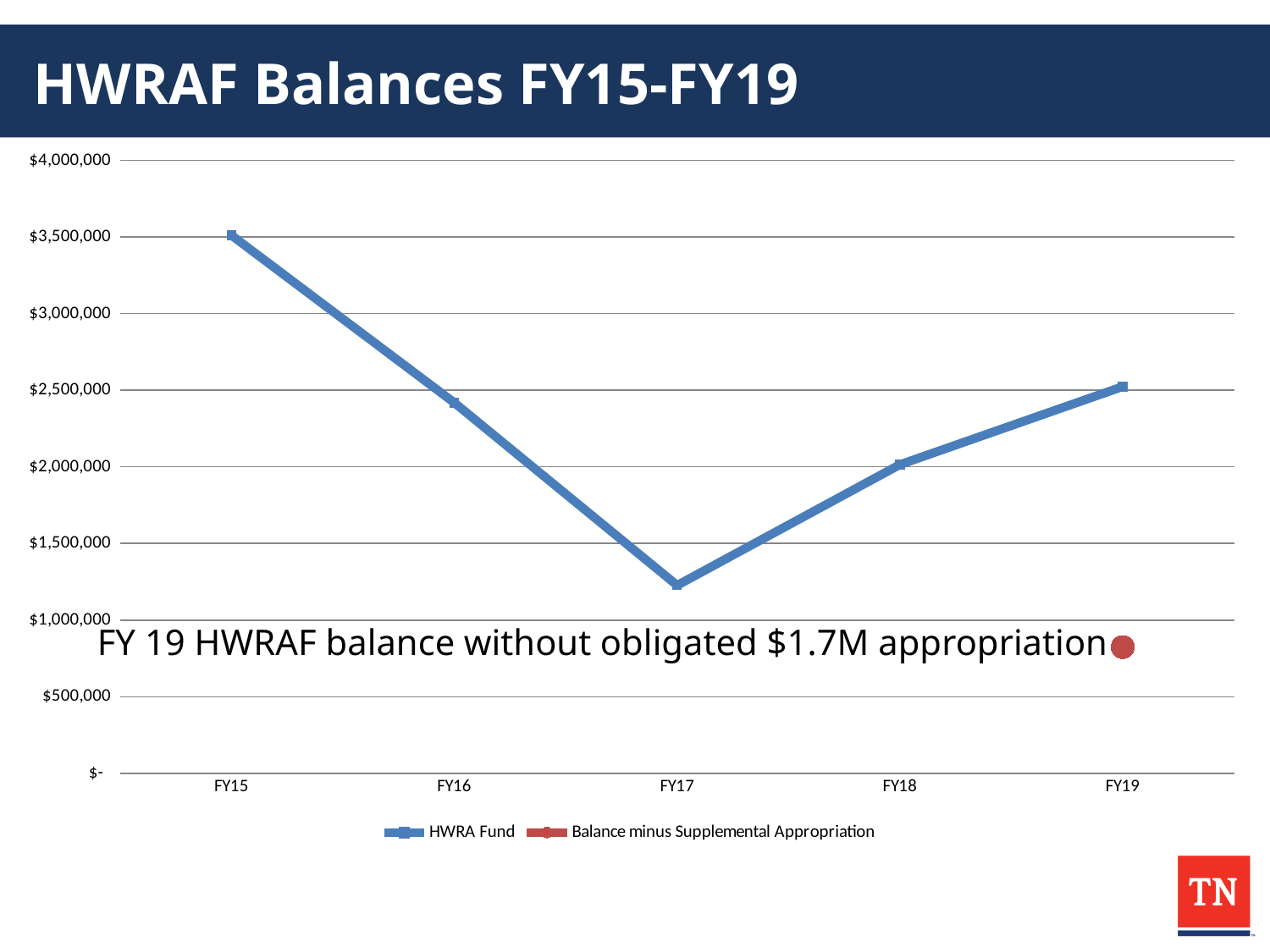
How does the HWRA Fund balance change from FY15 to FY17? It falls Is the Balance minus Supplemental Appropriation point for FY19 greater or less than $1,000,000? less What is the title of the chart? HWRAF Balances FY15-FY19 Is the HWRA Fund value for FY19 greater or less than $2,000,000? greater What kind of chart is shown on the slide? Line chart In which fiscal year is the HWRA Fund balance lowest? FY17 Is the HWRA Fund value for FY17 greater or less than $1,500,000? less Which is larger, the HWRA Fund balance in FY15 or in FY19? FY15 How many fiscal years are shown on the x axis? 5 In which fiscal year is the HWRA Fund balance highest? FY15 How many series does the legend list? 2